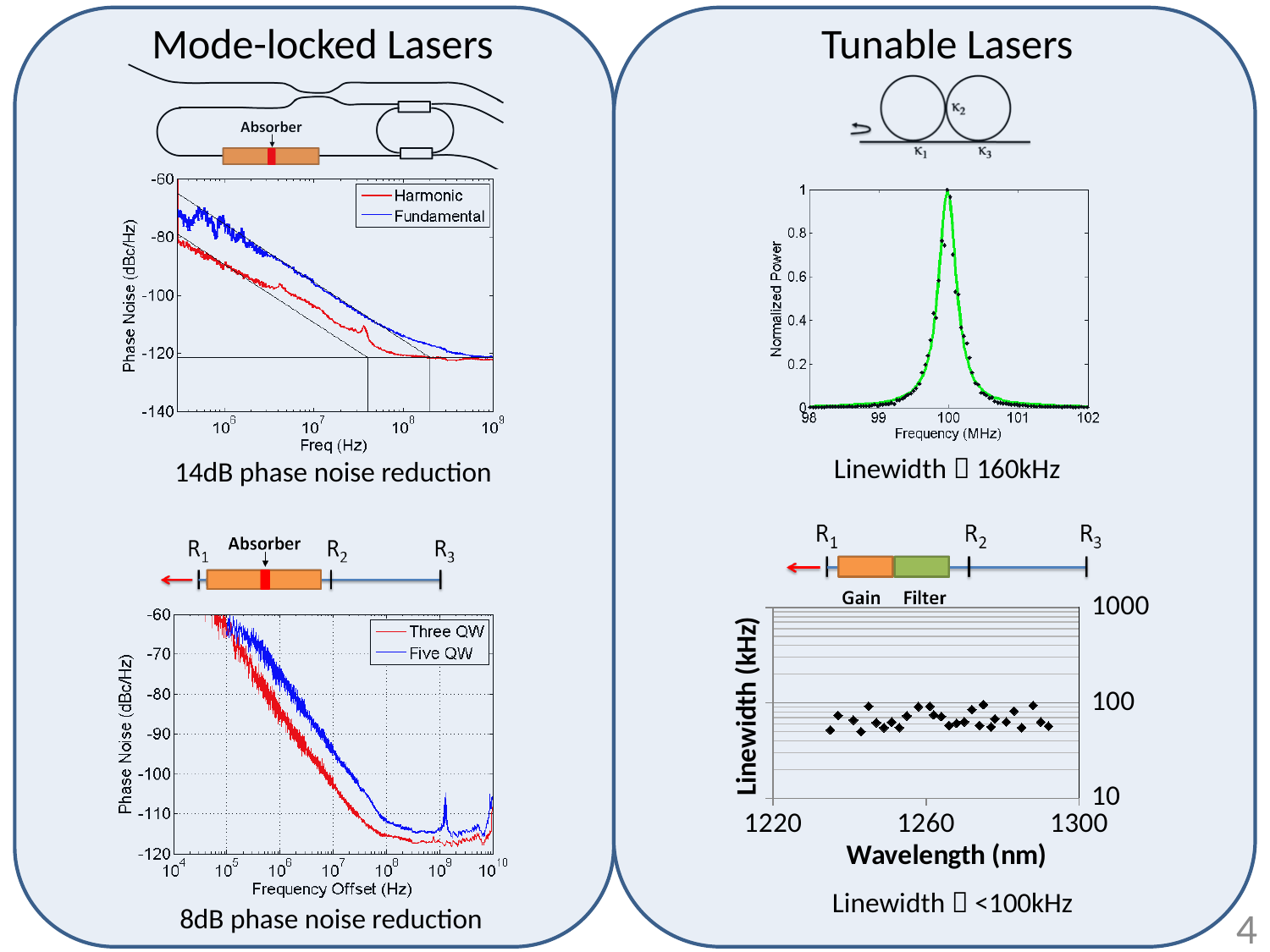
In the top-left phase noise chart, does the phase noise rise or fall as frequency increases along the x axis? fall In the top-left phase noise chart, what is the y-axis label? Phase Noise (dBc/Hz) In the bottom-left phase noise chart, does the phase noise rise or fall as the frequency offset increases from 10^5 Hz to 10^8 Hz? fall In the bottom-left phase noise chart, how many series does the legend list? 2 In the top-right Normalized Power chart, at what frequency does the normalized power reach its peak? 100 MHz In the top-left phase noise chart, how many series does the legend list? 2 In the top-right Normalized Power chart, what is the peak normalized power value? 1 In the bottom-left phase noise chart, which series has the higher phase noise at a frequency offset of 10^6 Hz, Three QW or Five QW? Five QW In the top-right Normalized Power chart, is the normalized power at 99 MHz greater or less than 0.2? less In the bottom-left phase noise chart, what is the x-axis label? Frequency Offset (Hz) In the bottom-right Linewidth versus Wavelength chart, are the plotted linewidth values greater or less than 1000 kHz? less What kind of chart is the bottom-right Linewidth versus Wavelength chart? scatter chart